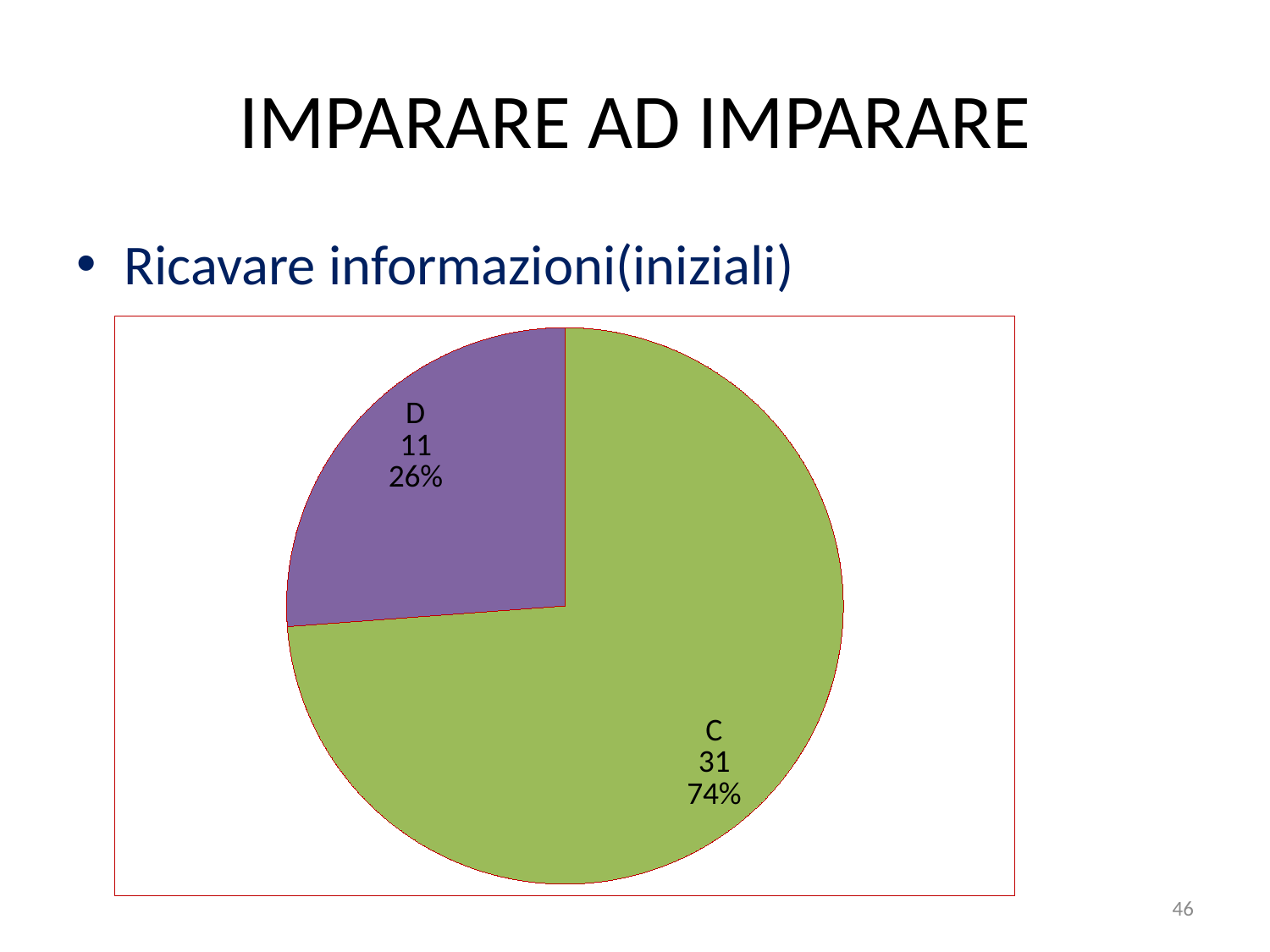
How many slices does the pie chart have? 2 What kind of chart is shown on the slide? pie chart What is the value for slice C? 31 What colour is the slice for D? purple Which slice is the largest? C What is the difference between the values of C and D? 20 What is the value for slice D? 11 Which is larger, the value for C or the value for D? C Which slice is the smallest? D What share of the pie does slice D represent? 26% What is the total of the values of all slices? 42 What share of the pie does slice C represent? 74%